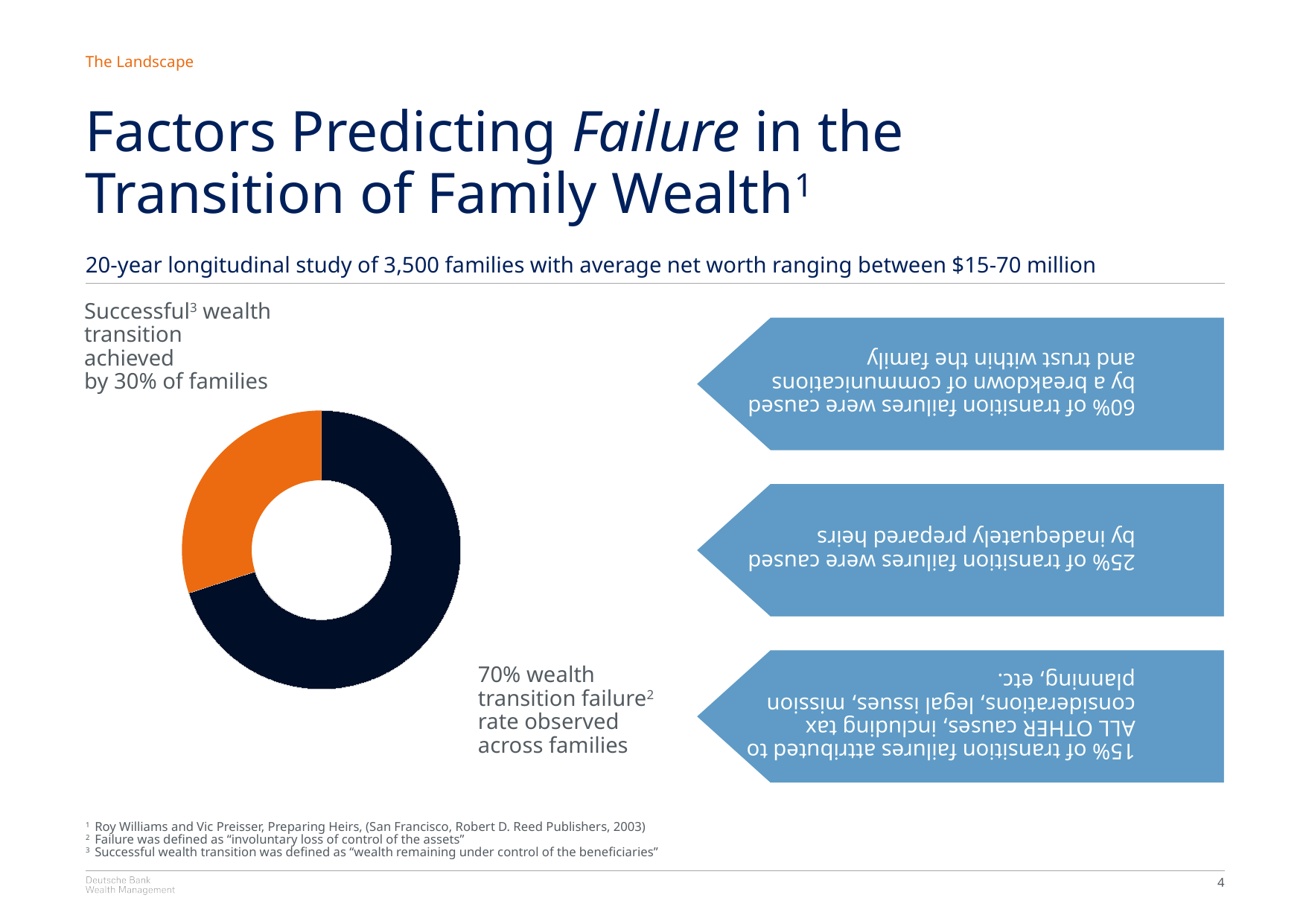
What do the two slices of the donut chart add up to? 100% Which slice of the donut chart is the smallest? Successful wealth transition (30%) How many slices does the donut chart have? 2 What wealth transition failure rate is shown by the donut chart? 70% What colour is the slice representing wealth transition failure in the donut chart? Dark navy What share of families achieved a successful wealth transition according to the donut chart? 30% What is the difference in percentage points between the failure rate and the success rate shown in the donut chart? 40 percentage points Which slice of the donut chart is larger: successful wealth transition or wealth transition failure? Wealth transition failure Is the share of families with a successful wealth transition greater or less than 50%? less What colour is the slice representing successful wealth transition in the donut chart? Orange What kind of chart is shown on the slide? Donut chart